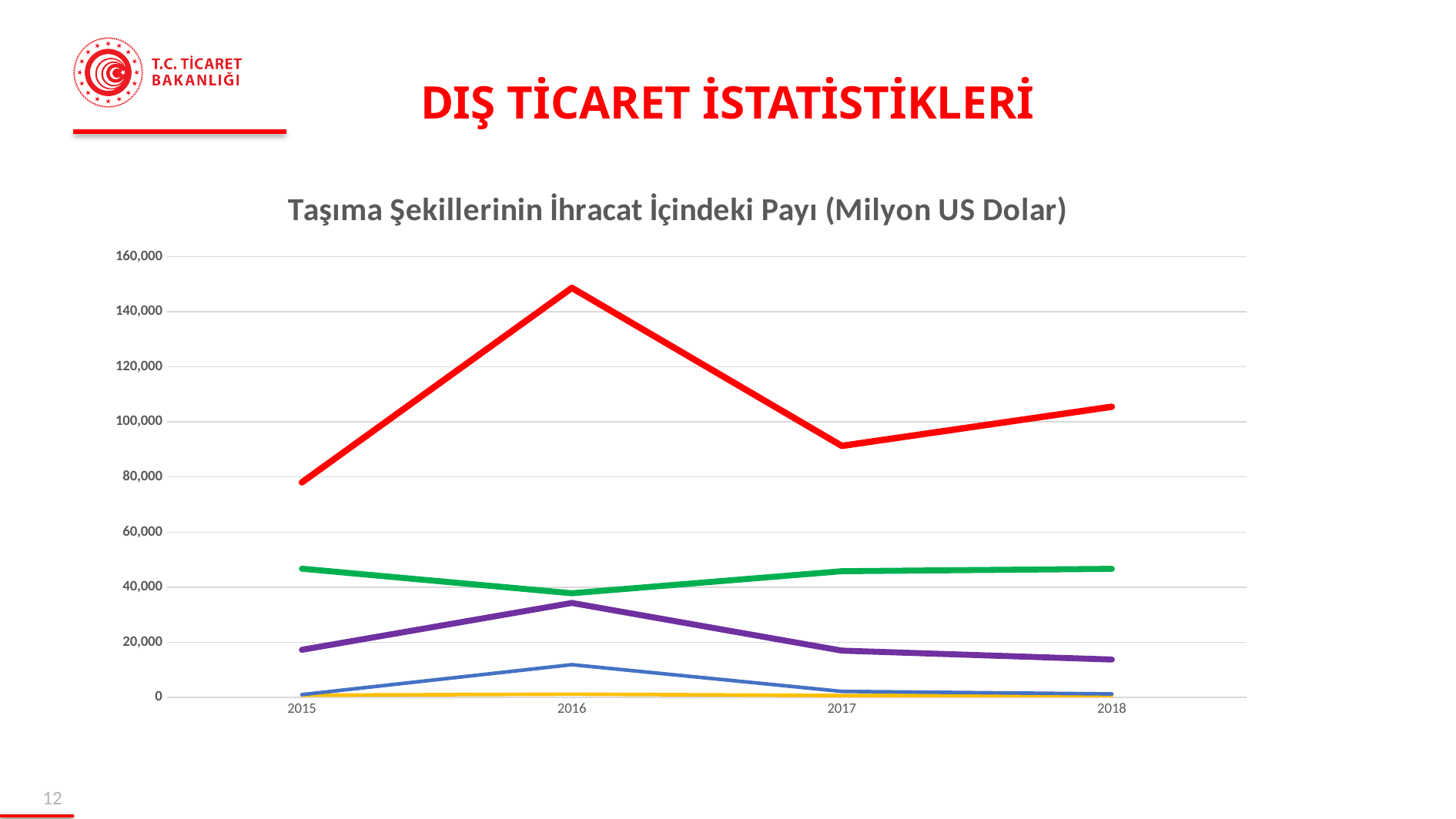
What is the title of the chart? Taşıma Şekillerinin İhracat İçindeki Payı (Milyon US Dolar) In which year does the red line reach its highest value? 2016 What kind of chart is shown on the slide? line chart Which line has the larger value in 2015, the red line or the green line? red line Is the value of the red line in 2016 greater or less than 140,000? greater Is the value of the purple line in 2018 greater or less than 20,000? less How many years are shown on the x axis of the chart? 4 Is the value of the green line in 2015 greater or less than 40,000? greater In which year does the red line have its lowest value? 2015 How many lines are plotted on the chart? 5 Does the red line rise or fall from 2016 to 2017? fall